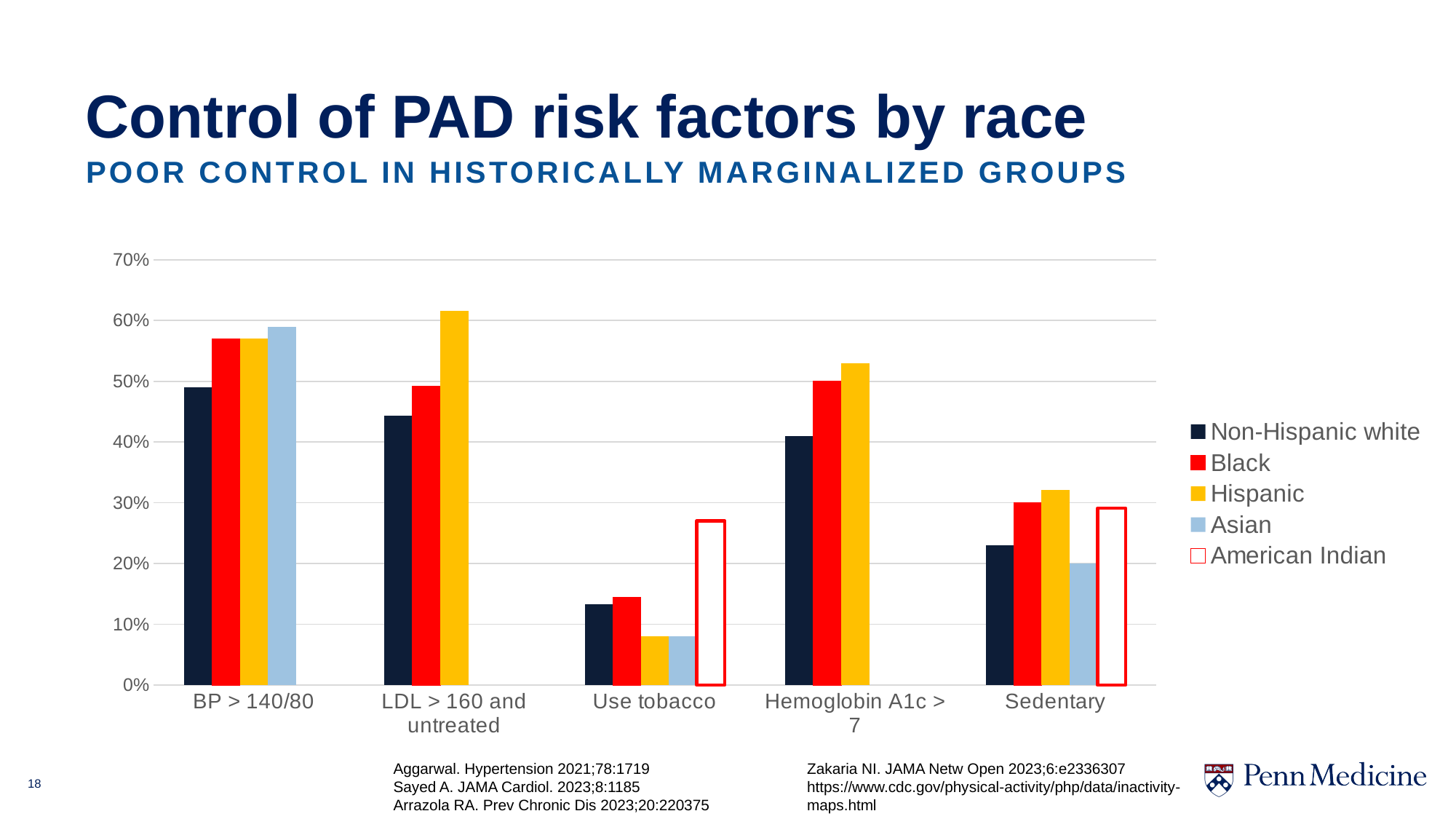
For Hemoglobin A1c > 7, which is larger: the Hispanic bar or the Non-Hispanic white bar? Hispanic Which group has the highest bar for LDL > 160 and untreated? Hispanic Which group has the lowest bar for Sedentary? Asian What kind of chart is shown on the slide? bar chart How many risk-factor categories are shown on the x axis? 5 Which legend series is drawn as an outlined, unfilled bar? American Indian Is the value for Non-Hispanic white in Hemoglobin A1c > 7 greater or less than 50%? less Is the value for Hispanic in LDL > 160 and untreated greater or less than 60%? greater How many series does the legend list? 5 For Use tobacco, which is larger: the Black bar or the Hispanic bar? Black Which group has the highest bar for Use tobacco? American Indian Is the value for Asian in BP > 140/80 greater or less than 50%? greater